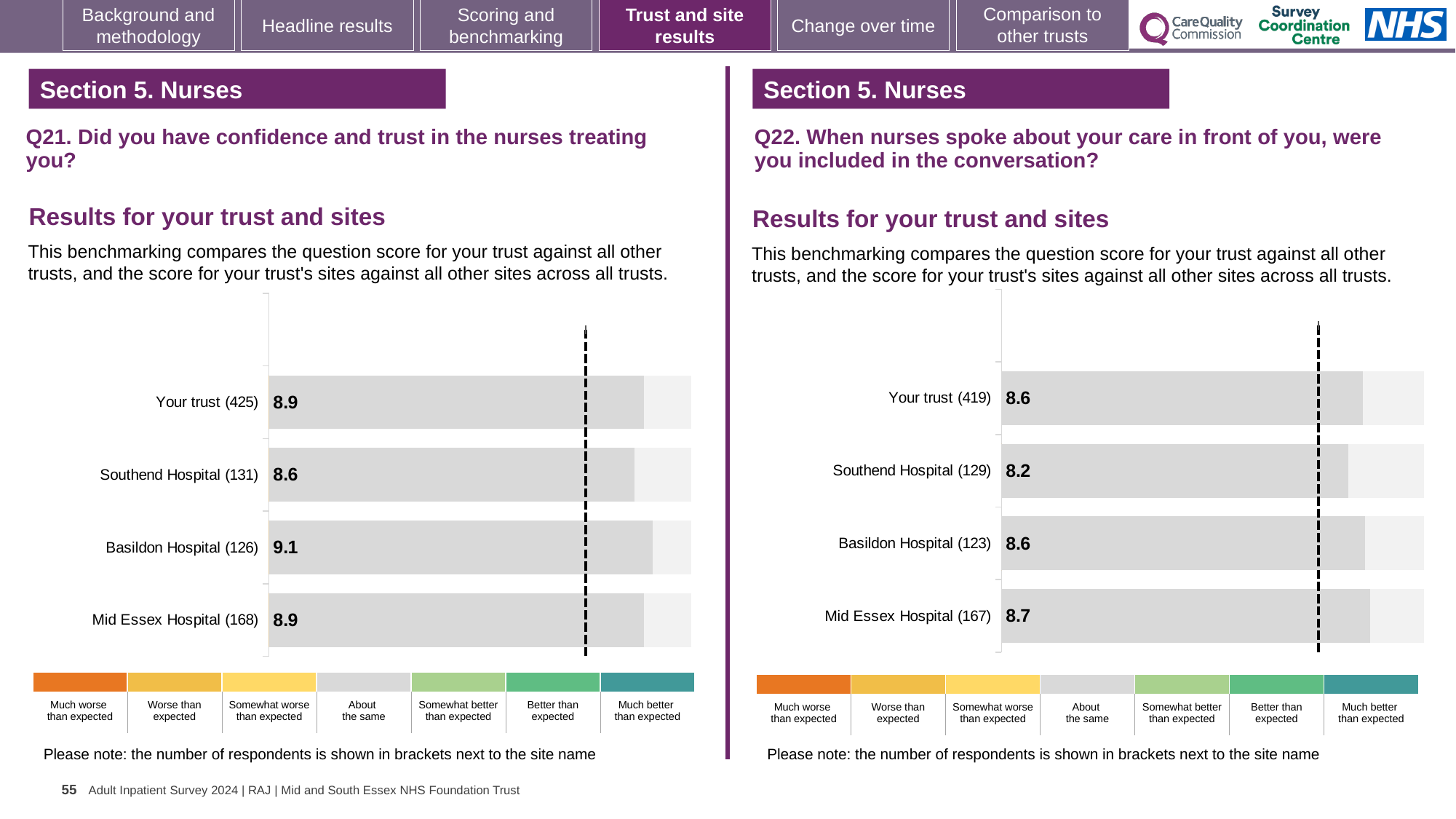
On the Q22 chart (right), which is larger, the score for Mid Essex Hospital or Southend Hospital? Mid Essex Hospital On the Q22 chart (right), which site or trust has the lowest score? Southend Hospital On the Q21 chart (left), what is the score for Your trust? 8.9 On the Q22 chart (right), what is the score for Mid Essex Hospital? 8.7 On the Q21 chart (left), how many bars are plotted? 4 On the Q21 chart (left), what is the difference between the scores for Basildon Hospital and Southend Hospital? 0.5 On the Q21 chart (left), which site or trust has the lowest score? Southend Hospital On the Q21 chart (left), what is the score for Basildon Hospital? 9.1 What kind of chart is used on the Q21 chart (left)? Bar chart On the Q21 chart (left), which site or trust has the highest score? Basildon Hospital On the Q22 chart (right), what is the difference between the scores for Your trust and Southend Hospital? 0.4 On the Q22 chart (right), what is the score for Southend Hospital? 8.2